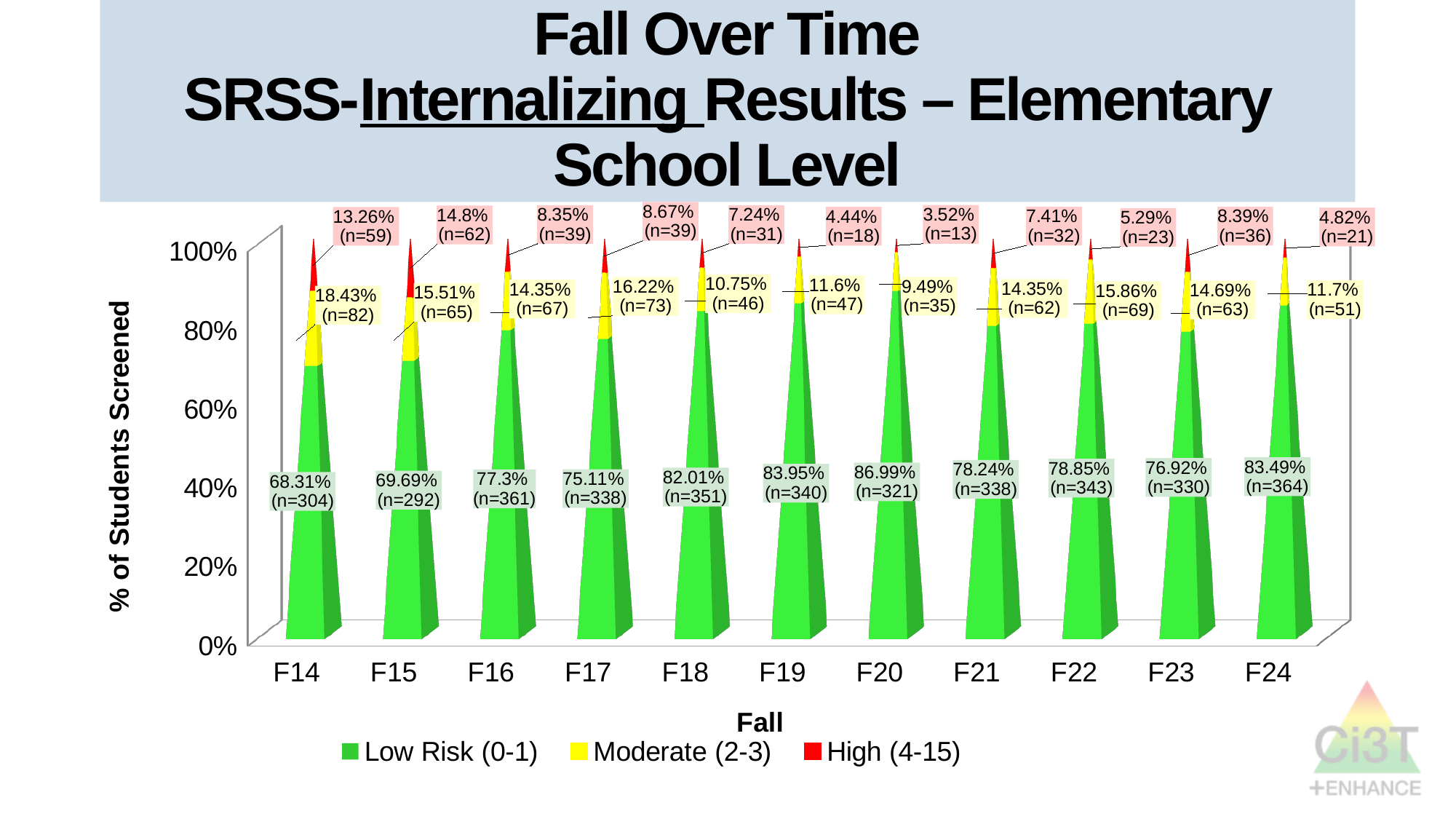
How many students were in the Moderate (2-3) category in F17? n=73 How many fall time points are shown on the x axis? 11 What kind of chart is shown on the slide? Stacked bar chart What is the difference in Low Risk (0-1) percentage between F20 and F14? 18.68 percentage points Which fall has the highest Low Risk (0-1) percentage? F20 Which has a larger Low Risk (0-1) percentage, F18 or F19? F19 Which fall has the highest High (4-15) percentage? F15 What is the label of the y axis? % of Students Screened What percentage of students were in the Low Risk (0-1) category in F20? 86.99% What percentage of students were in the High (4-15) category in F14? 13.26% How many series does the legend list? 3 Which fall has the lowest Low Risk (0-1) percentage? F14